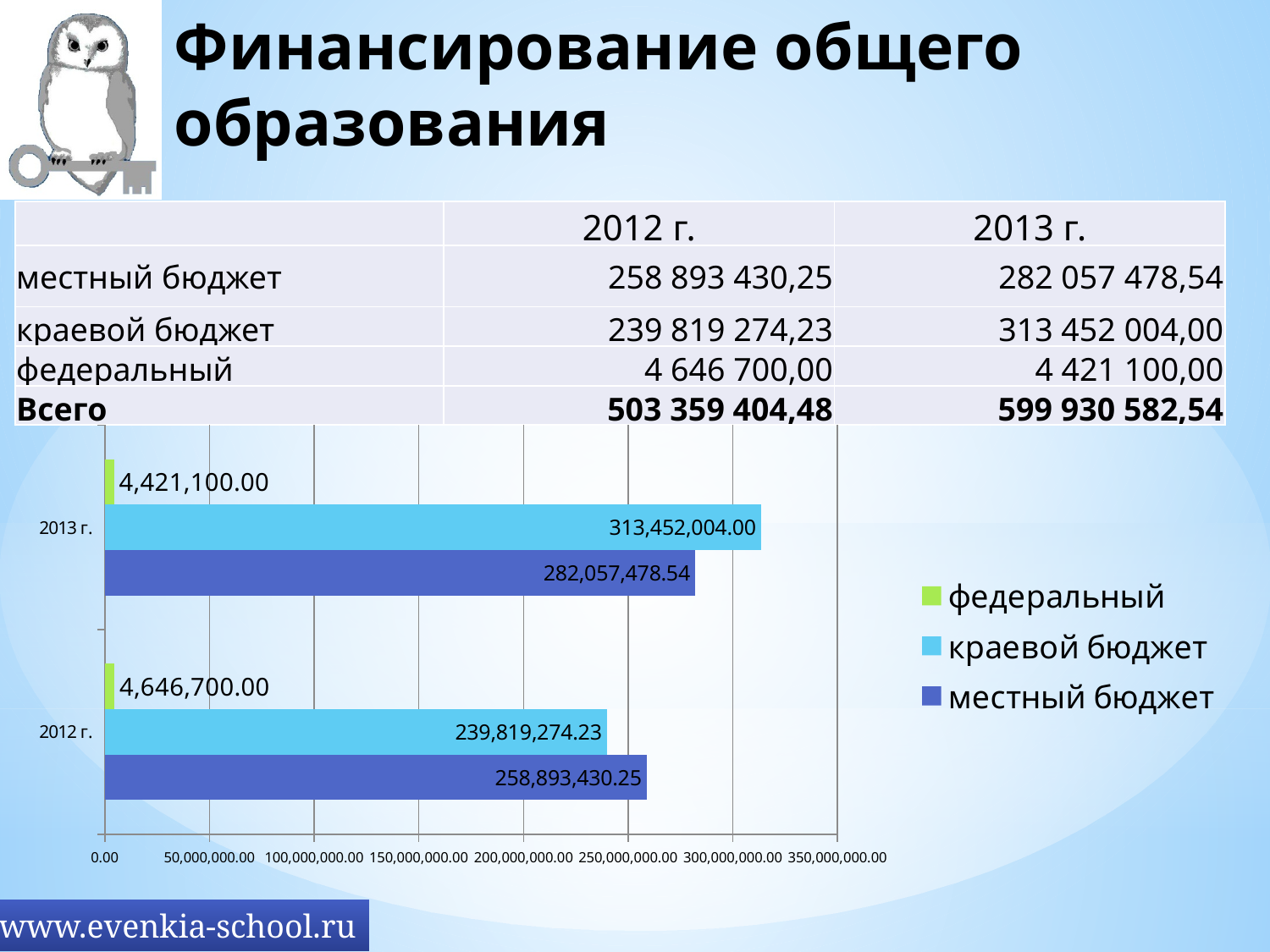
What is the value of местный бюджет for 2012 г. in the bar chart? 258,893,430.25 What kind of chart is shown on the slide? bar chart What is the difference between федеральный in 2012 г. and in 2013 г. in the chart? 225,600.00 What is the value of федеральный for 2013 г. in the bar chart? 4,421,100.00 In 2012 г., which is larger in the chart: местный бюджет or краевой бюджет? местный бюджет Which bar in the chart has the smallest value? федеральный, 2013 г. How many series does the chart legend list? 3 Is the value for краевой бюджет in 2013 г. greater or less than 300,000,000.00? greater By how much did краевой бюджет increase from 2012 г. to 2013 г. according to the chart? 73,632,729.77 What is the value of краевой бюджет for 2013 г. in the bar chart? 313,452,004.00 How many years (categories) are shown on the chart's vertical axis? 2 Which series has the longest bar in the chart, and for which year? краевой бюджет, 2013 г.